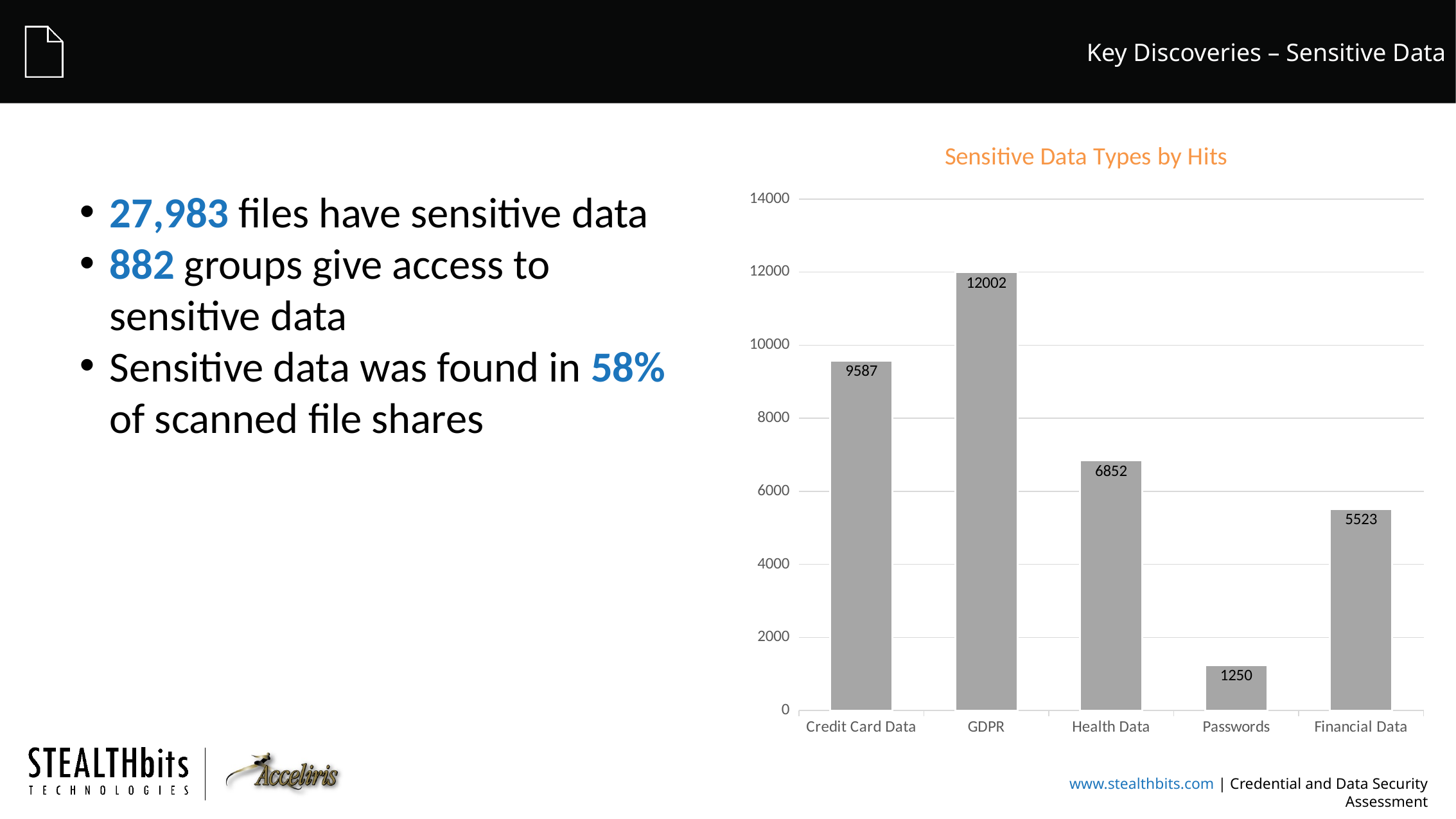
What is the title of the chart? Sensitive Data Types by Hits What is the value for Credit Card Data in the chart? 9587 Which category has the lowest number of hits? Passwords What is the value for Financial Data in the chart? 5523 What is the value for GDPR in the Sensitive Data Types by Hits chart? 12002 Which category has the highest number of hits? GDPR What kind of chart is shown on the slide? Bar chart How many categories are shown in the chart? 5 What is the difference between the values for GDPR and Credit Card Data? 2415 What is the value for Passwords in the chart? 1250 What is the difference between the values for Health Data and Financial Data? 1329 Which is larger, the value for Health Data or the value for Financial Data? Health Data